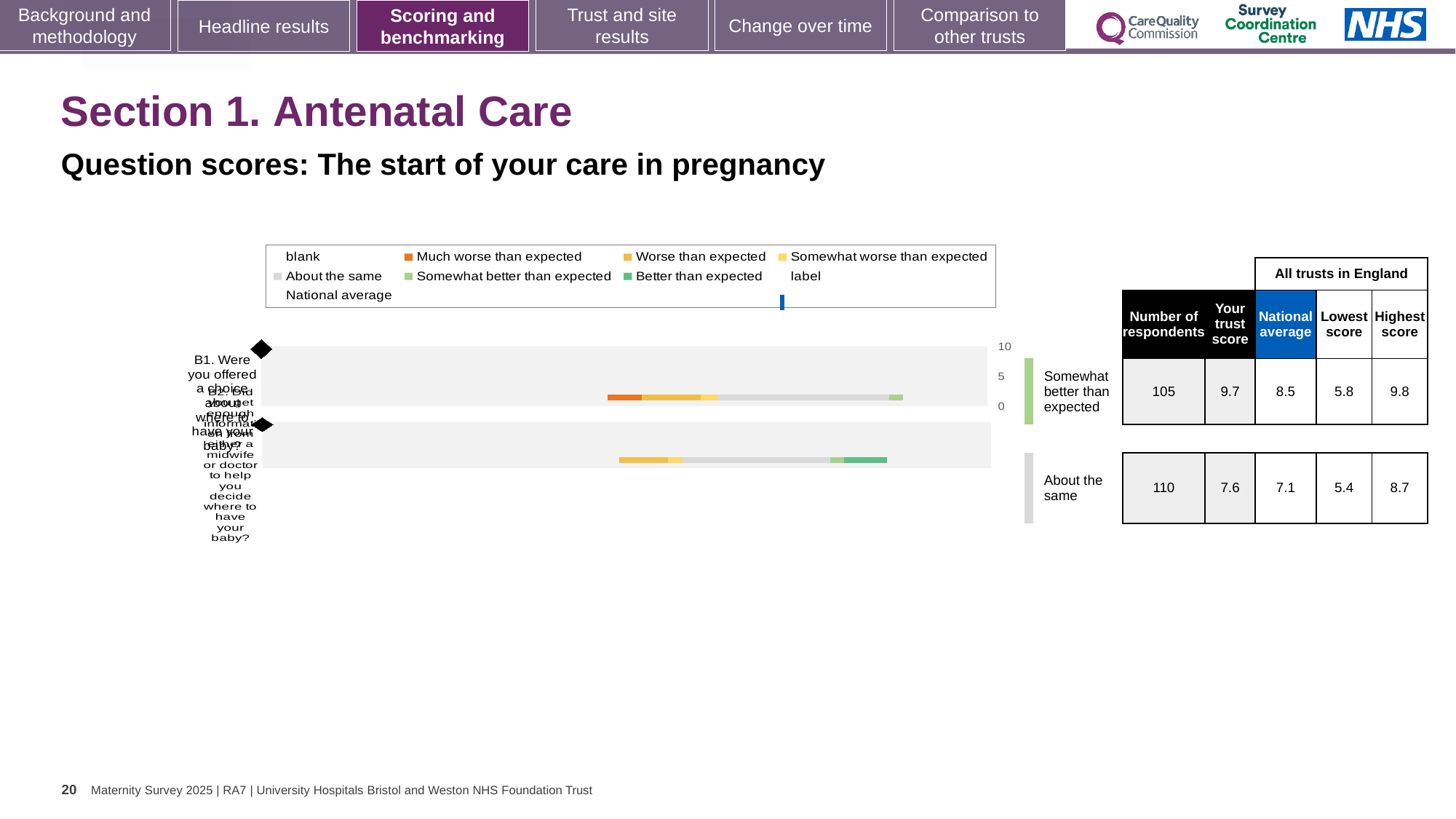
How many respondents are shown for the first row of the table (benchmarked 'Somewhat better than expected')? 105 Which row has the higher 'Your trust score': the row benchmarked 'Somewhat better than expected' or the row benchmarked 'About the same'? Somewhat better than expected What heading appears above the National average, Lowest score and Highest score columns in the table? All trusts in England In the table next to the chart, what is the National average for the row benchmarked 'About the same'? 7.1 For the row benchmarked 'About the same', what is the difference between the Highest score and the Lowest score? 3.3 What benchmark category is shown for the second row of the chart? About the same For the row benchmarked 'Somewhat better than expected', how much higher is the trust score than the National average? 1.2 What is the Lowest score shown for the row benchmarked 'Somewhat better than expected'? 5.8 In the table next to the chart, what is the 'Your trust score' for the first row (benchmarked 'Somewhat better than expected')? 9.7 How many question rows are plotted in the chart? 2 What kind of chart is shown on the slide? Bar chart What is the Highest score shown for the row benchmarked 'About the same'? 8.7